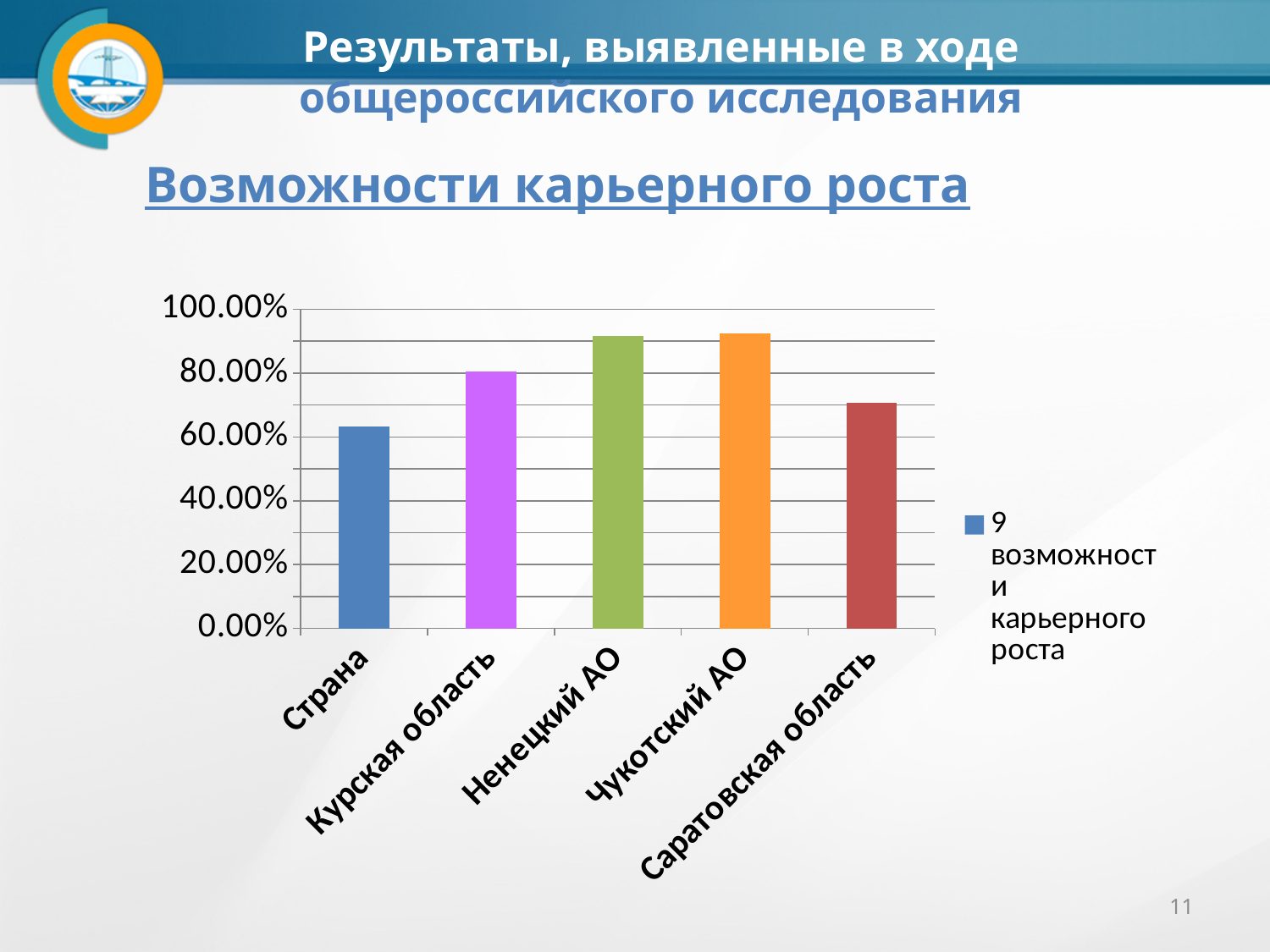
Is the value for Ненецкий АО greater or less than 80.00%? greater Which has a larger value, Саратовская область or Ненецкий АО? Ненецкий АО What is the title of the chart shown on the slide? Возможности карьерного роста How many categories are shown on the x axis of the chart? 5 Is the value for Страна greater or less than 60.00%? greater How many series does the chart legend list? 1 Which category has the lowest value in the chart? Страна Is the value for Страна greater or less than 80.00%? less Which has a larger value, Курская область or Страна? Курская область What kind of chart is shown on the slide? bar chart